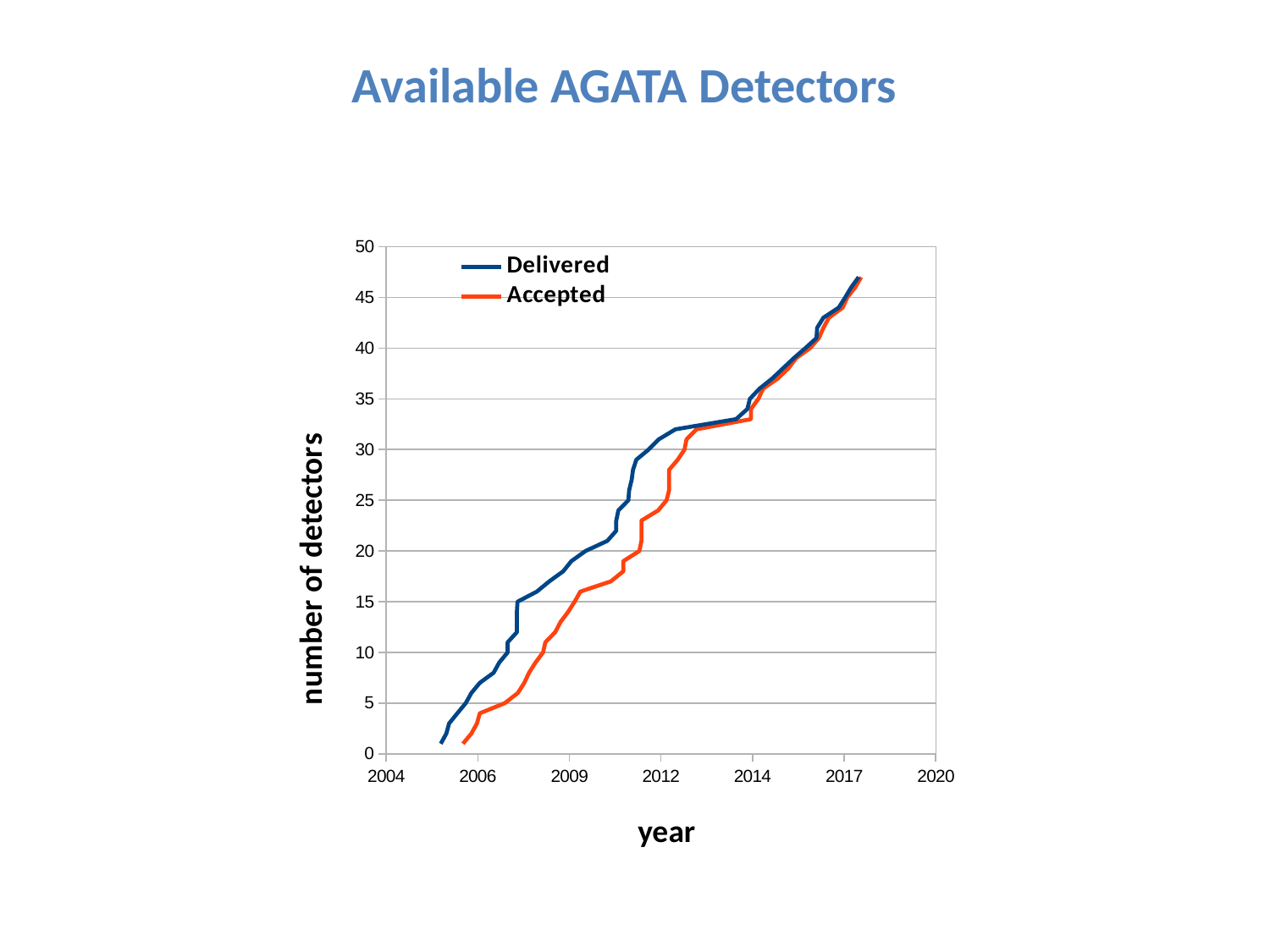
Is the value of the Delivered series at 2009 greater or less than 15? greater What is the title of the chart? Available AGATA Detectors At 2009, which series has the larger value, Delivered or Accepted? Delivered Do the values of the Accepted series rise or fall as the year increases? rise How many series does the legend list? 2 What is the label of the vertical axis? number of detectors At 2012, which series has the larger value, Delivered or Accepted? Delivered Is the value of the Accepted series at 2009 greater or less than 20? less Is the value of the Delivered series at 2012 greater or less than 30? greater Do the values of the Delivered series rise or fall as the year increases? rise What kind of chart is shown on the slide? line chart